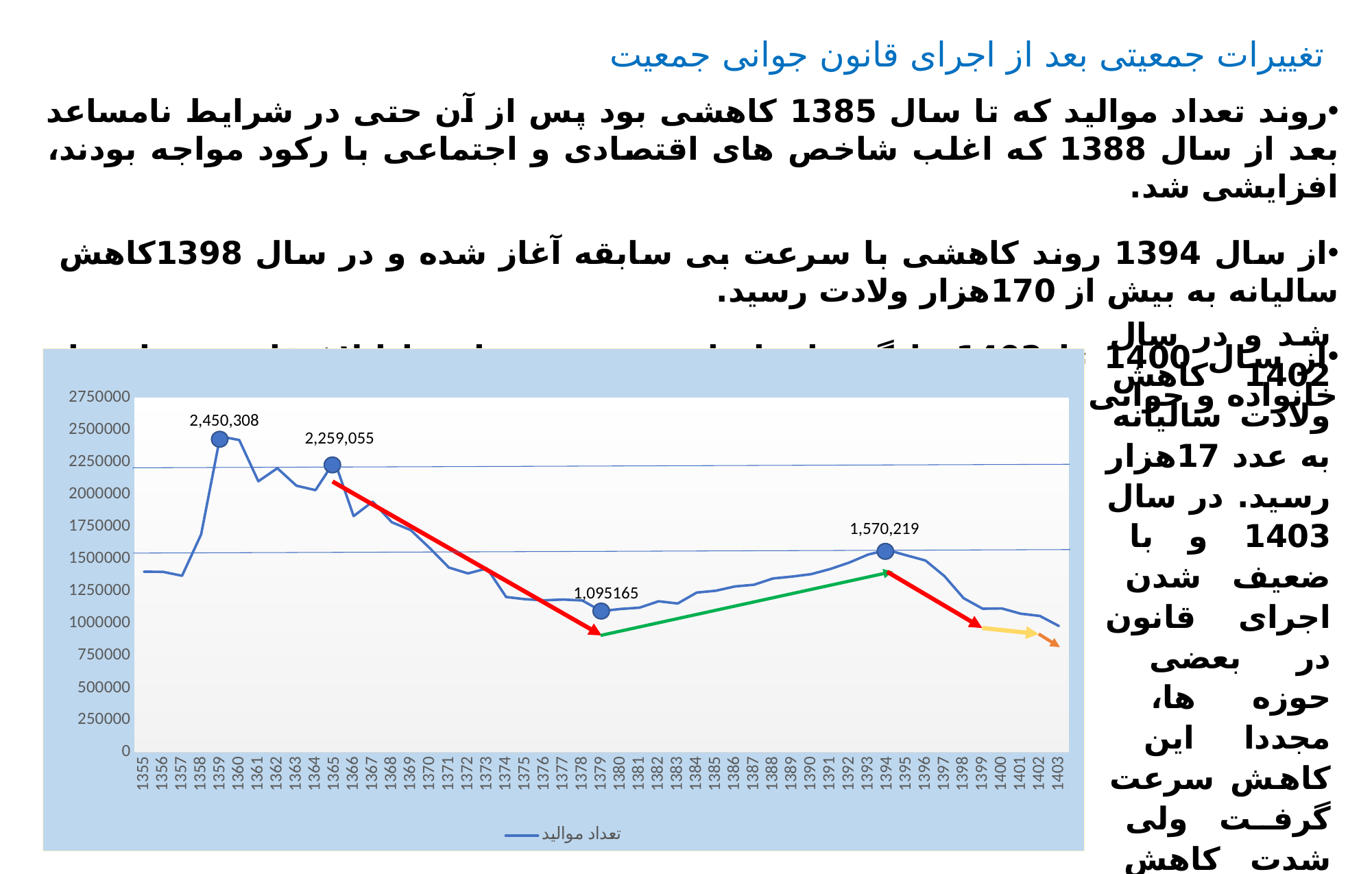
What is the value labelled for the year 1394? 1,570,219 What kind of chart is shown on the slide? line chart What is the value labelled for the year 1359? 2,450,308 Which of the labelled years has the lowest value? 1379 Which of the labelled years has the highest value? 1359 Which year has the larger value, 1365 or 1394? 1365 Is the value for 1355 greater or less than 1250000? greater Is the value for 1388 greater or less than 1500000? less What is the value labelled for the year 1365? 2,259,055 What is the difference between the labelled values for 1365 and 1394? 688,836 How many years are shown on the x axis? 49 What is the difference between the labelled values for 1359 and 1365? 191,253